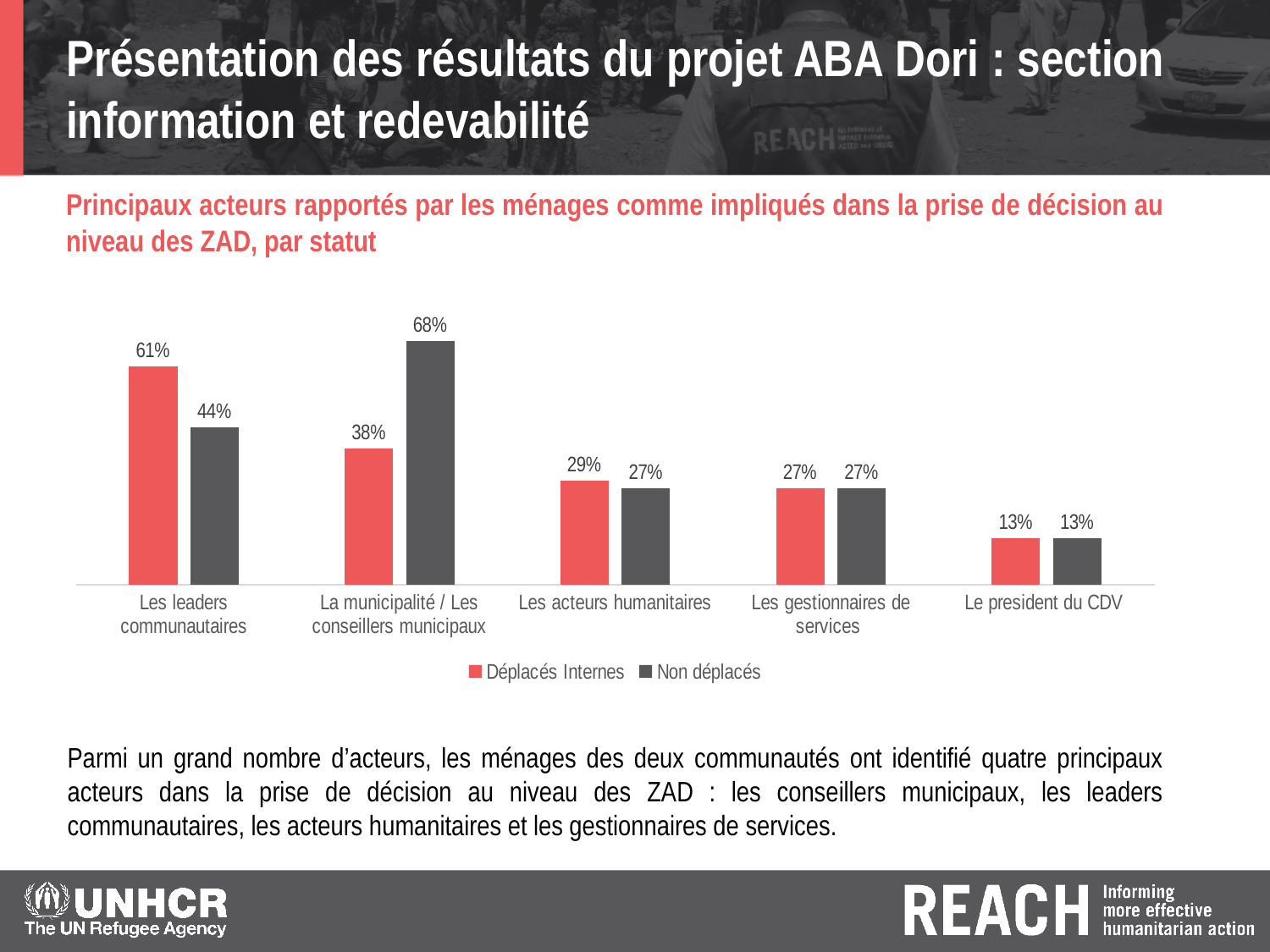
What percentage of Déplacés Internes households reported Les leaders communautaires? 61% What is the Non déplacés value for La municipalité / Les conseillers municipaux? 68% What is the difference between the Non déplacés and Déplacés Internes values for La municipalité / Les conseillers municipaux? 30% Which category has the lowest Déplacés Internes value? Le president du CDV What kind of chart is shown on the slide? Bar chart What is the Déplacés Internes value for Les acteurs humanitaires? 29% What colour are the Déplacés Internes bars? Red How many categories are shown on the x axis of the chart? 5 Which category has the highest Non déplacés value? La municipalité / Les conseillers municipaux How many series does the legend list? 2 For Les acteurs humanitaires, which is larger: the Déplacés Internes value or the Non déplacés value? Déplacés Internes What is the difference between the Déplacés Internes and Non déplacés values for Les leaders communautaires? 17%